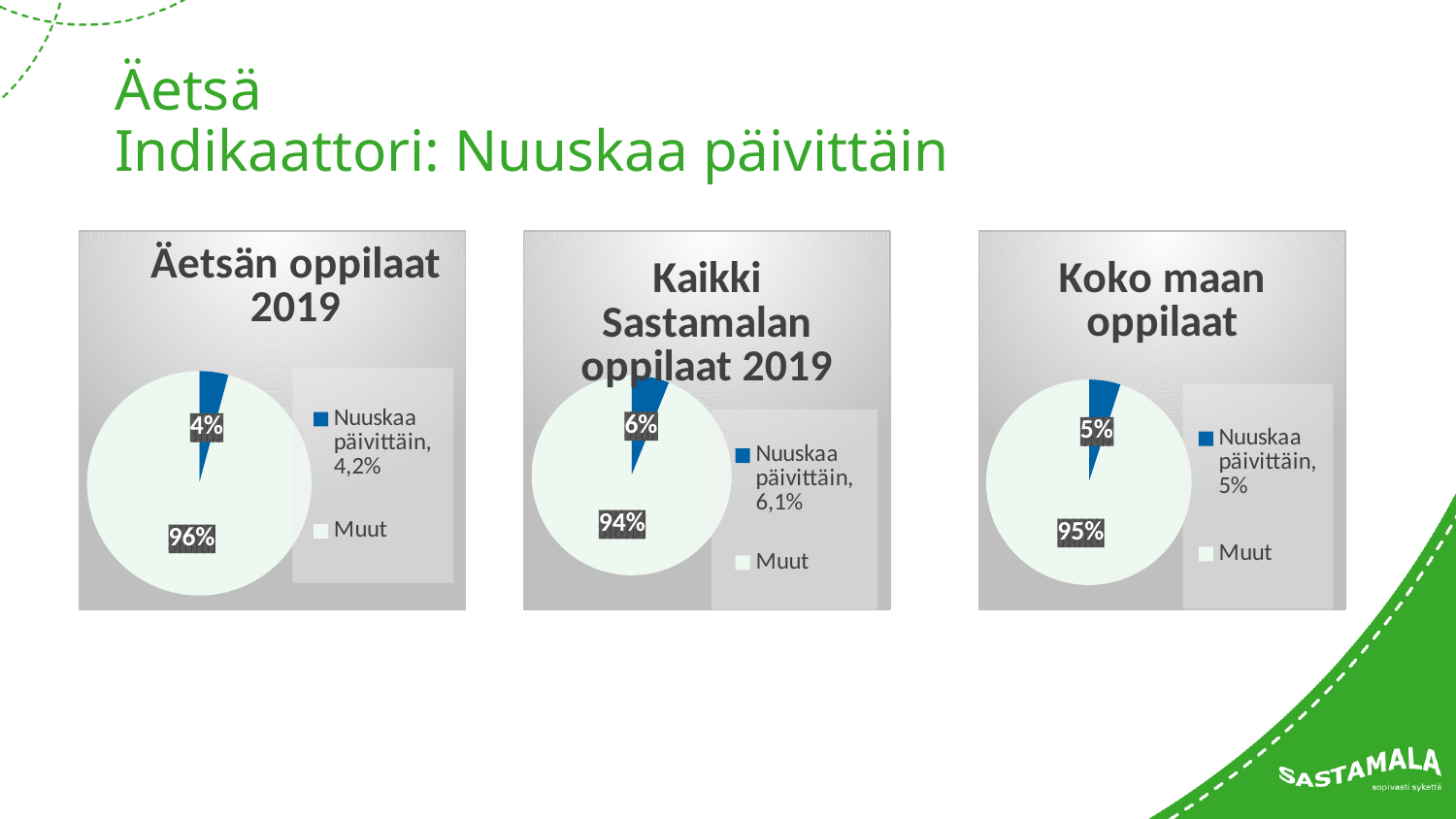
In the 'Kaikki Sastamalan oppilaat 2019' chart, what percentage is shown on the 'Muut' slice? 94% How many slices does the 'Kaikki Sastamalan oppilaat 2019' pie chart have? 2 What kind of chart is the 'Koko maan oppilaat' chart? Pie chart In the 'Äetsän oppilaat 2019' chart, which slice is the largest? Muut In the 'Äetsän oppilaat 2019' chart, what percentage is shown on the 'Nuuskaa päivittäin' slice? 4% In the 'Koko maan oppilaat' chart, what percentage is shown on the 'Muut' slice? 95% In the 'Kaikki Sastamalan oppilaat 2019' chart, what value does the legend give for 'Nuuskaa päivittäin'? 6,1% Which is larger: the 'Nuuskaa päivittäin' share in the 'Kaikki Sastamalan oppilaat 2019' chart or in the 'Äetsän oppilaat 2019' chart? Kaikki Sastamalan oppilaat 2019 In the 'Äetsän oppilaat 2019' chart, what percentage is shown on the 'Muut' slice? 96% In the 'Kaikki Sastamalan oppilaat 2019' chart, what percentage is shown on the 'Nuuskaa päivittäin' slice? 6% In the 'Koko maan oppilaat' chart, what percentage is shown on the 'Nuuskaa päivittäin' slice? 5% In the 'Äetsän oppilaat 2019' chart, what value does the legend give for 'Nuuskaa päivittäin'? 4,2%